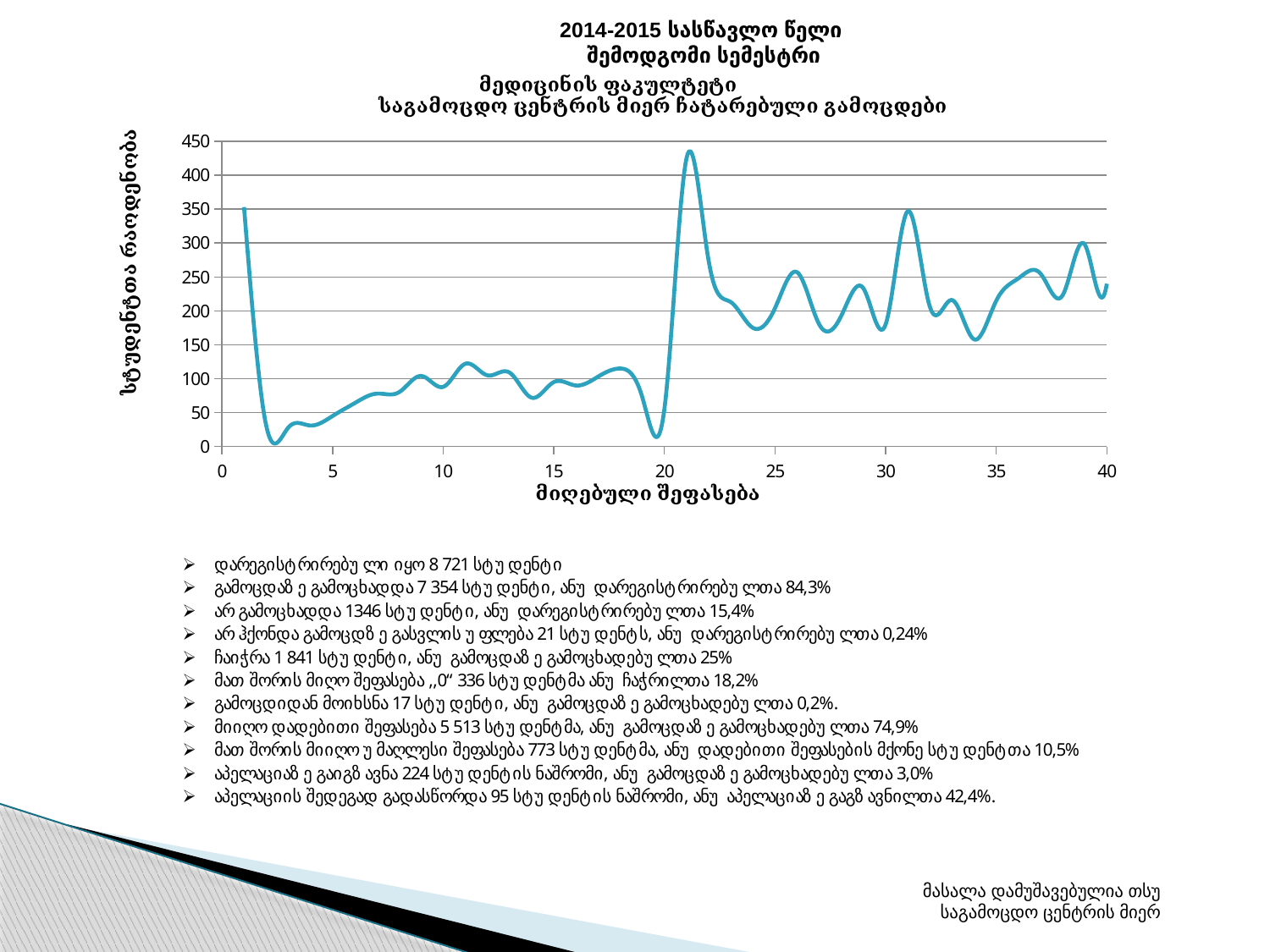
At which x-axis value (მიღებული შეფასება) does the line reach its highest point? 21 Is the value of the line at x = 31 greater or less than 300? greater Is the value of the line at x = 10 greater or less than 150? less Is the value of the line at x = 34 greater or less than 200? less Does the line rise or fall between x = 20 and x = 21? rise What is the label of the x axis? მიღებული შეფასება Which has the larger value: the line at x = 21 or at x = 31? x = 21 What kind of chart is shown on the slide? line chart What is the highest tick value shown on the y axis? 450